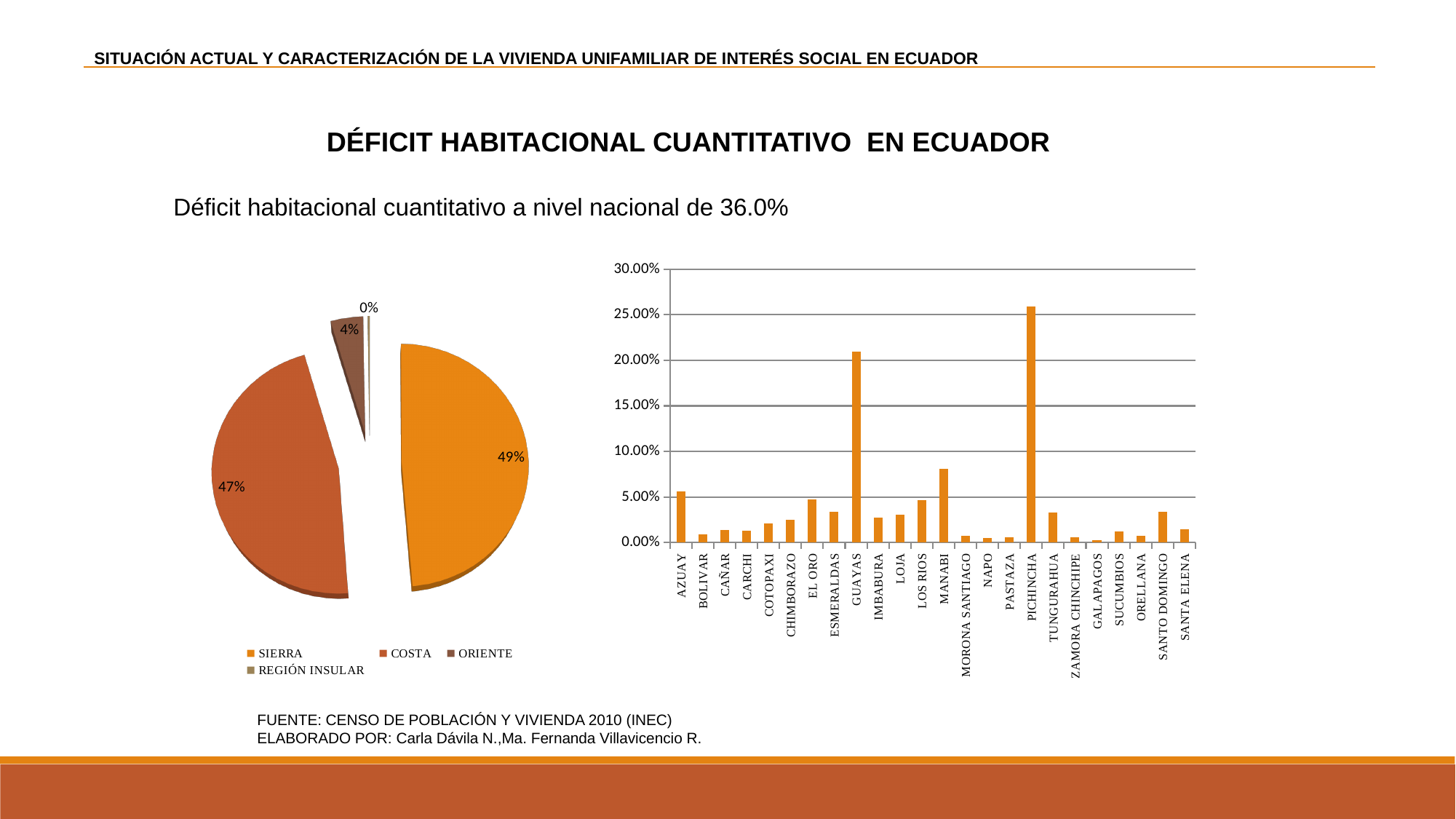
In the pie chart on the left, what share does SIERRA have? 49% In the pie chart on the left, how many regions does the legend list? 4 In the bar chart on the right, is the value for GUAYAS greater or less than 15.00%? greater In the bar chart on the right, which province has the highest value? PICHINCHA In the bar chart on the right, how many provinces are shown on the x axis? 24 In the pie chart on the left, how many percentage points larger is SIERRA's share than COSTA's? 2% In the pie chart on the left, which region has the smallest slice? REGIÓN INSULAR In the pie chart on the left, which region has the largest slice? SIERRA In the bar chart on the right, is the value for MANABI greater or less than 10.00%? less In the pie chart on the left, what share does COSTA have? 47% In the bar chart on the right, which is larger, the value for GUAYAS or the value for PICHINCHA? PICHINCHA In the pie chart on the left, what share does ORIENTE have? 4%